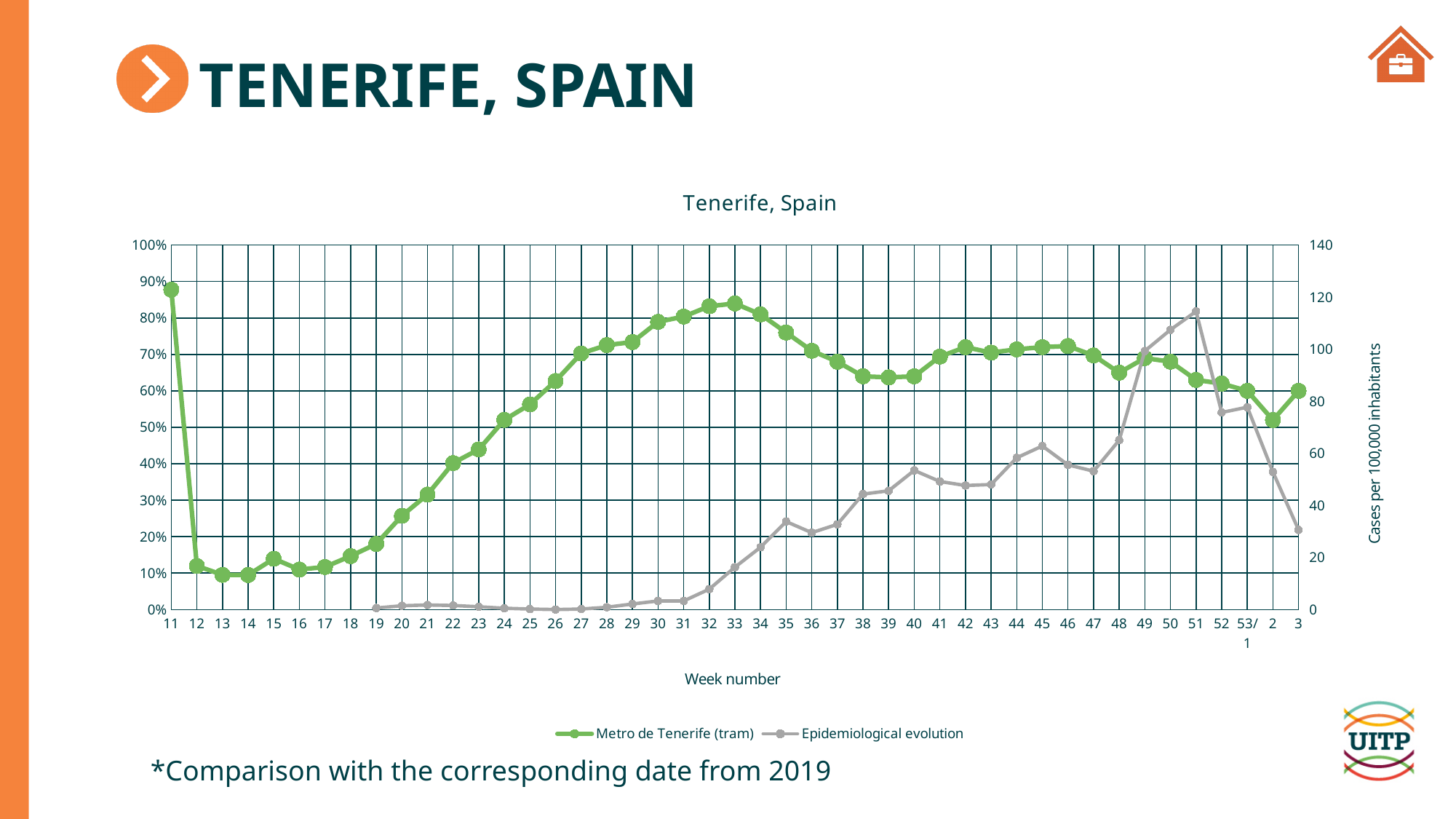
Is the Metro de Tenerife (tram) value at week 33 greater or less than 80%? greater Does the Metro de Tenerife (tram) series rise or fall between week 14 and week 33? Rise Is the Metro de Tenerife (tram) value at week 13 greater or less than 20%? less Is the Epidemiological evolution value at week 35 greater or less than 40? less How many week points are plotted along the x axis? 45 How many series does the legend list? 2 What are the two series named in the legend? Metro de Tenerife (tram) and Epidemiological evolution Which is larger for Metro de Tenerife (tram): the value at week 33 or the value at week 40? Week 33 What is the label of the right-hand vertical axis? Cases per 100,000 inhabitants What kind of chart is shown on the slide? Line chart At which week does the Epidemiological evolution series reach its highest value? 51